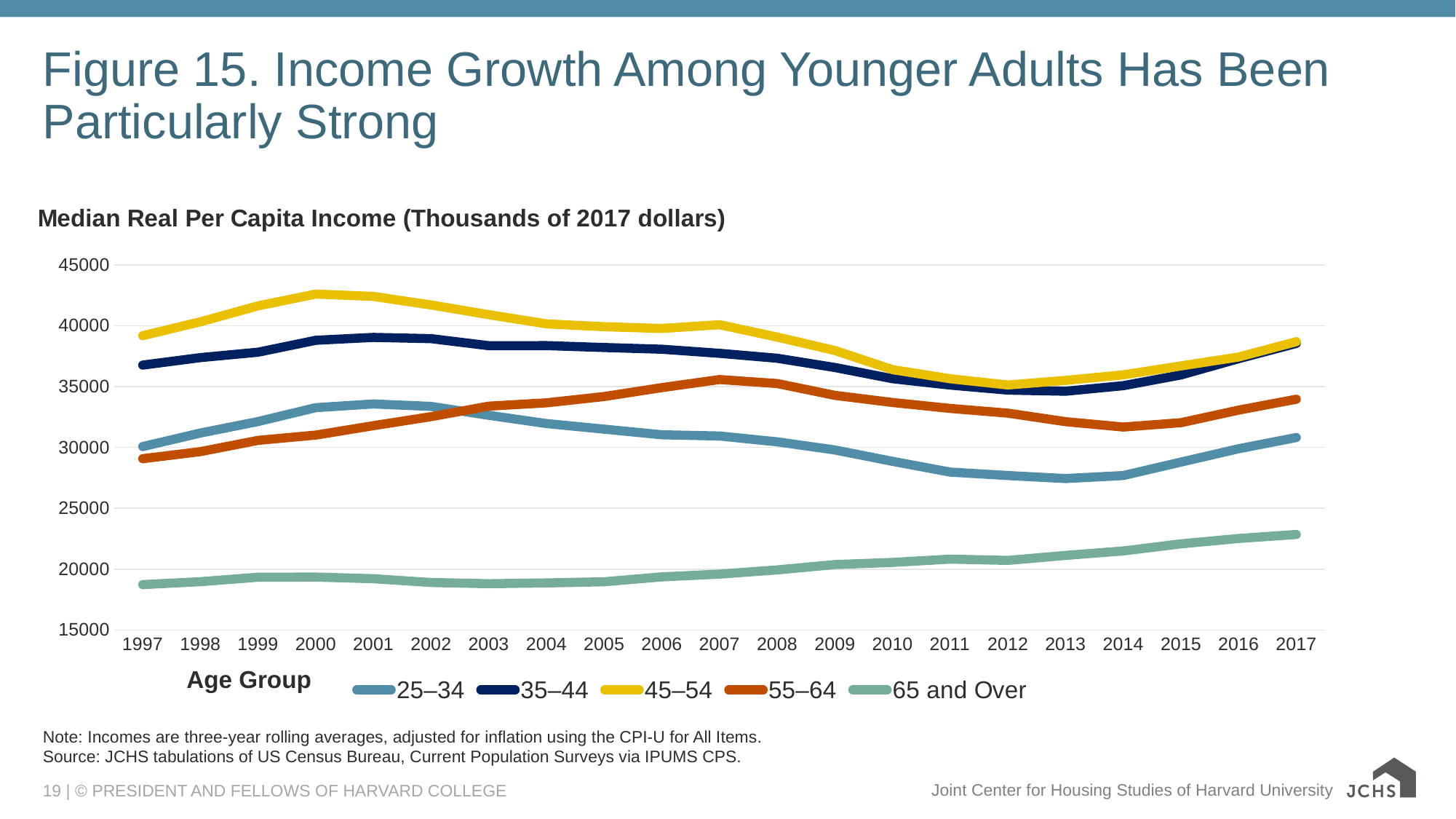
Does the value for the 65 and Over group rise or fall from 2007 to 2017? rise How many years are shown along the x axis? 21 Is the value for the 65 and Over group in 1997 greater or less than 20000? less Which age group has the highest median income in 2000? 45–54 Is the value for the 25–34 group in 2013 greater or less than 30000? less What is the title of the chart? Median Real Per Capita Income (Thousands of 2017 dollars) Which age group has the lowest median income in 2017? 65 and Over Is the value for the 45–54 group in 2000 greater or less than 40000? greater What is the title of the legend? Age Group In 2010, which has the larger value: the 55–64 group or the 25–34 group? 55–64 What kind of chart is shown on the slide? line chart How many age groups does the legend list? 5